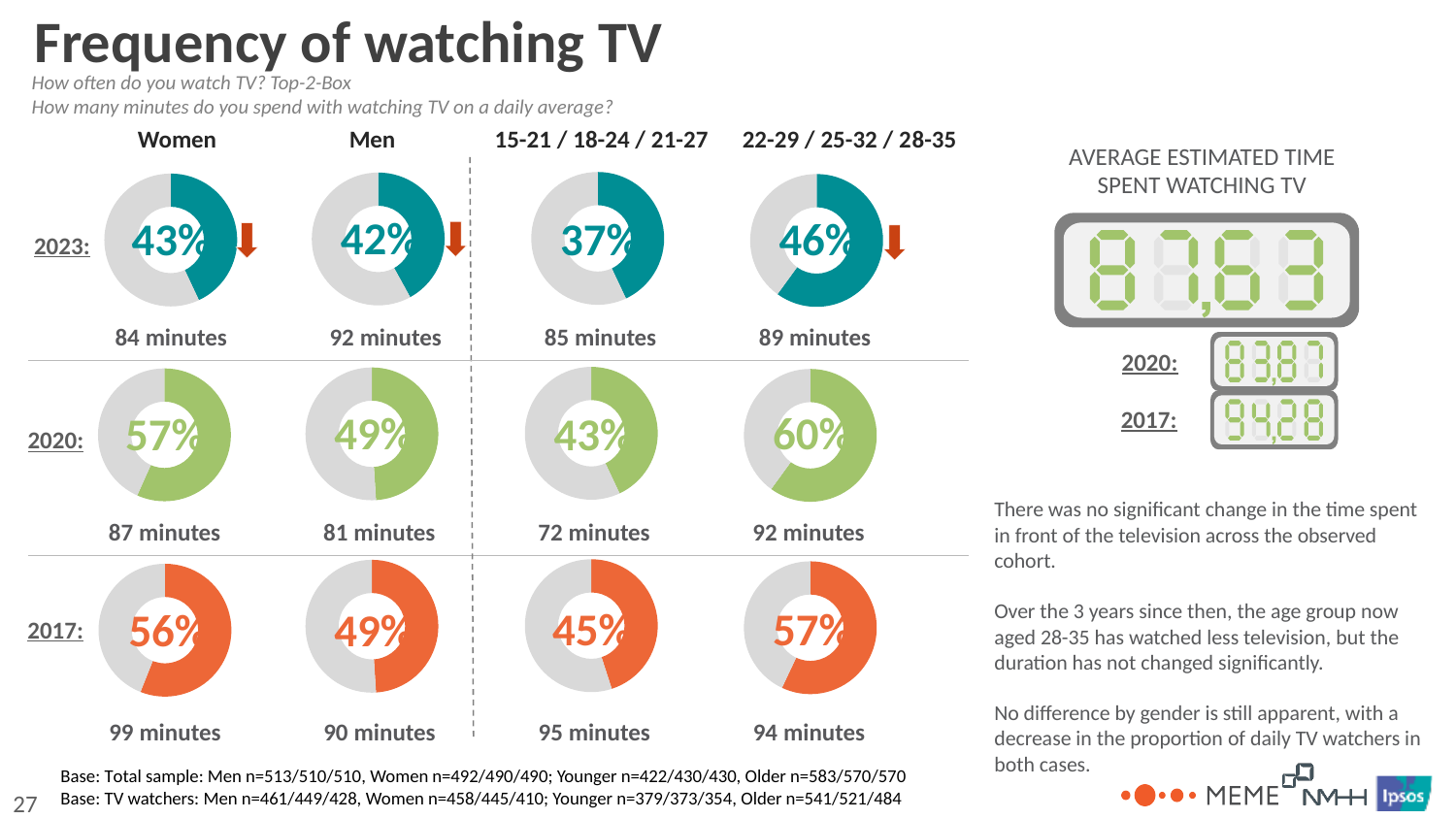
Across the four donut charts in the 2020 row, which group has the lowest percentage? 15-21 / 18-24 / 21-27 How many minutes are shown below the 2017 donut chart for Women? 99 minutes In the 2023 row, what percentage is shown in the donut chart for Women? 43% How many donut charts are shown in the 2023 row? 4 In the 2020 row, what percentage is shown in the donut chart for the 22-29 / 25-32 / 28-35 age group? 60% In the 2017 row, what percentage is shown in the donut chart for the 15-21 / 18-24 / 21-27 age group? 45% In the 2023 row, what percentage is shown in the donut chart for Men? 42% Across the four donut charts in the 2023 row, which group has the highest percentage? 22-29 / 25-32 / 28-35 What is the difference in percentage points between the Women donut charts for 2020 and 2023? 14 In the 2017 row, which donut chart shows a higher percentage: Women or Men? Women What value does the large digital display for average estimated time spent watching TV show? 87,63 What type of chart is used to show the Top-2-Box percentages for each group and year? Donut chart